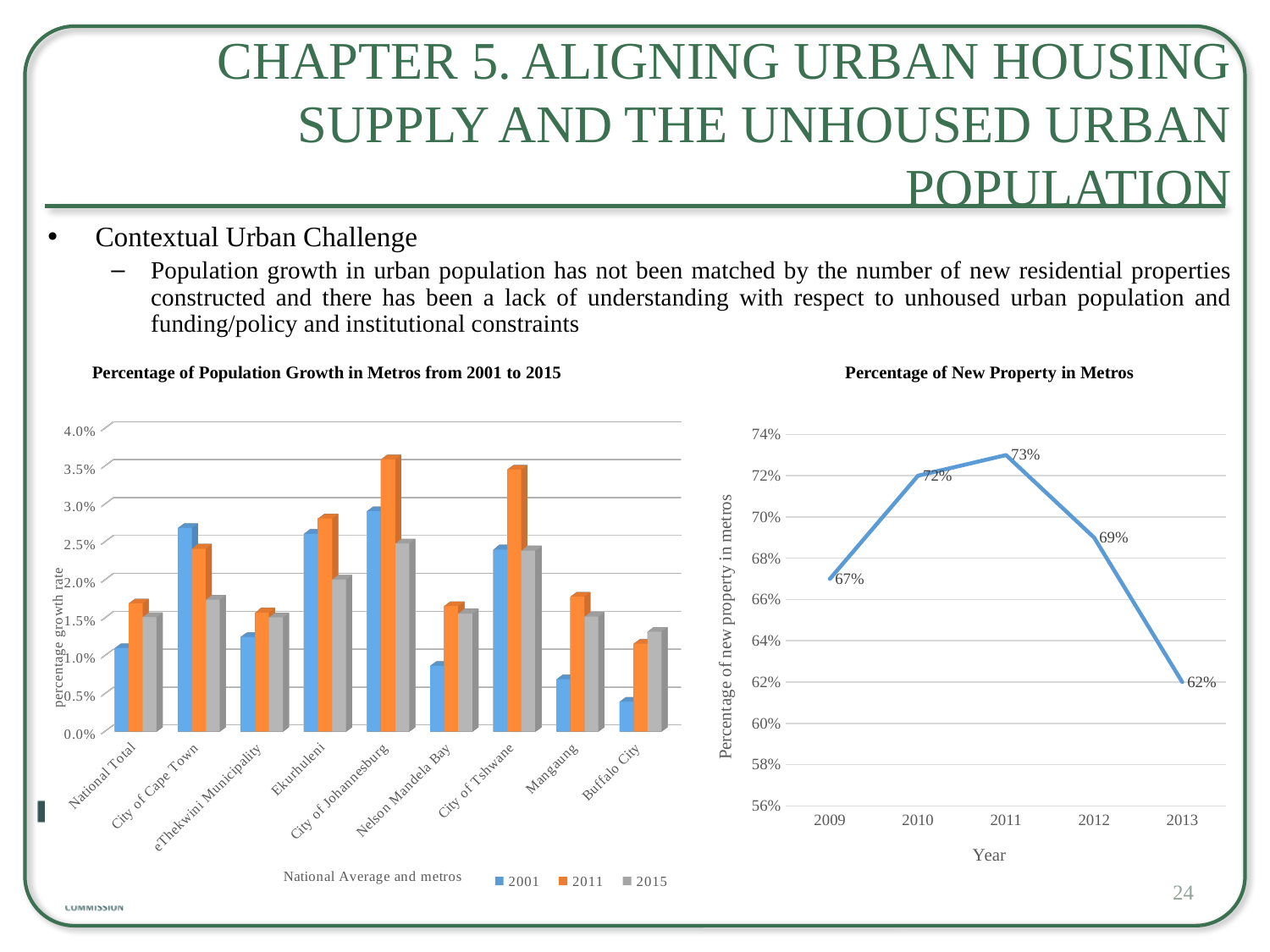
On the 'Percentage of Population Growth in Metros from 2001 to 2015' chart, how many series does the legend list? 3 What kind of chart is 'Percentage of Population Growth in Metros from 2001 to 2015'? Bar chart On the 'Percentage of New Property in Metros' chart, which year has the highest value? 2011 On the 'Percentage of New Property in Metros' chart, which is larger, the value for 2010 or the value for 2012? 2010 On the 'Percentage of Population Growth in Metros from 2001 to 2015' chart, which category has the lowest 2001 value? Buffalo City On the 'Percentage of New Property in Metros' chart, what is the value for 2011? 73% On the 'Percentage of New Property in Metros' chart, how do the values change from 2011 to 2013? They fall On the 'Percentage of Population Growth in Metros from 2001 to 2015' chart, is the 2001 value for Buffalo City greater or less than 1.0%? less On the 'Percentage of New Property in Metros' chart, how many years are plotted? 5 On the 'Percentage of New Property in Metros' chart, what is the difference between the 2011 and 2013 values? 11 percentage points On the 'Percentage of New Property in Metros' chart, what is the value for 2009? 67% On the 'Percentage of New Property in Metros' chart, which year has the lowest value? 2013